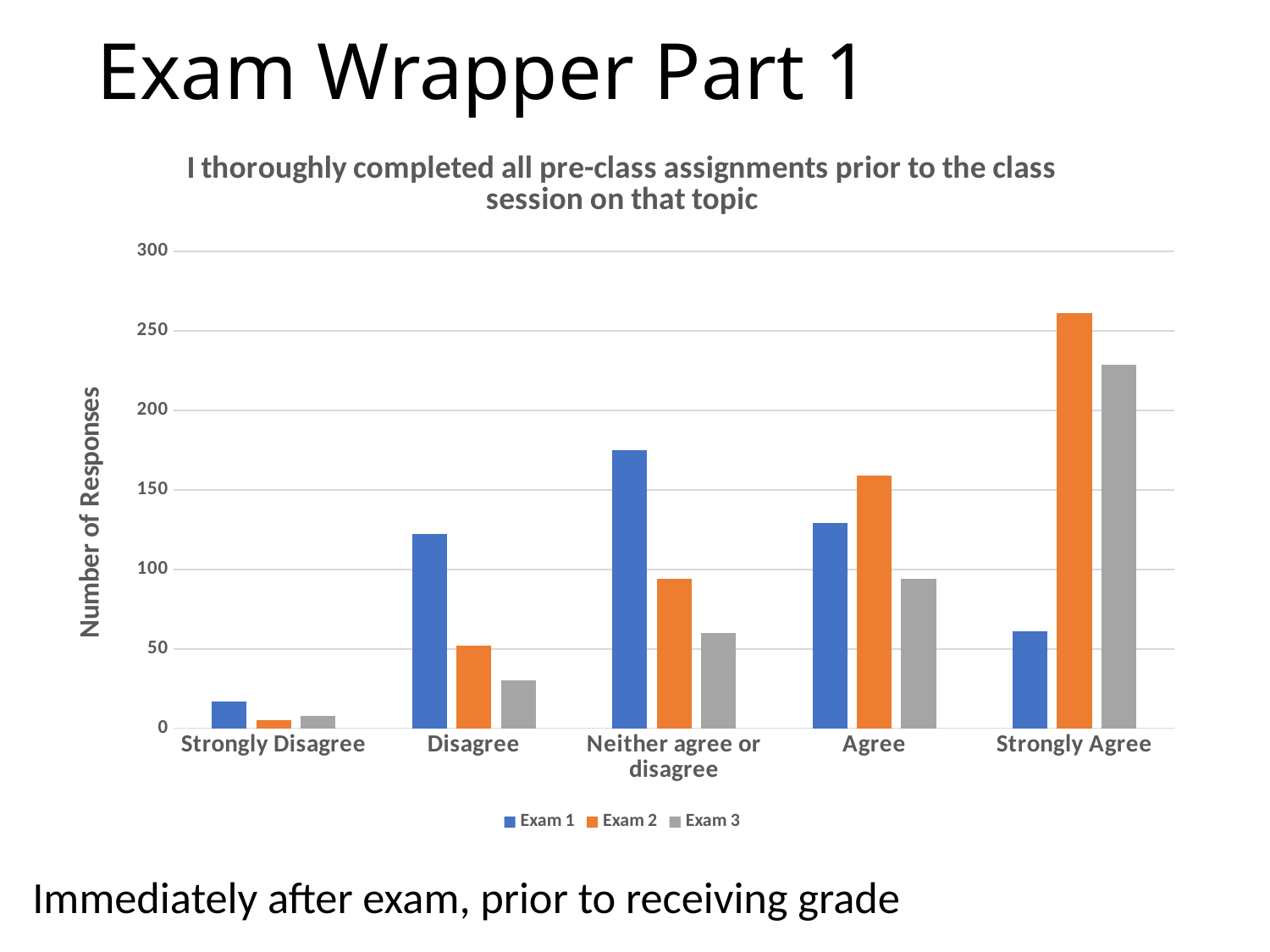
What is the label on the vertical axis of the chart? Number of Responses For Exam 1, which response category has the highest number of responses? Neither agree or disagree How many series does the legend list? 3 For Exam 3, which response category has the lowest number of responses? Strongly Disagree For Exam 2, which response category has the highest number of responses? Strongly Agree Is the value for Exam 1 in the Disagree category greater or less than 100? greater How many response categories are shown on the x axis? 5 In the Agree category, which is larger: Exam 1 or Exam 2? Exam 2 What kind of chart is shown on the slide? bar chart Is the value for Exam 3 in the Disagree category greater or less than 50? less In the Strongly Agree category, which is larger: Exam 1 or Exam 3? Exam 3 Is the value for Exam 2 in the Strongly Agree category greater or less than 250? greater